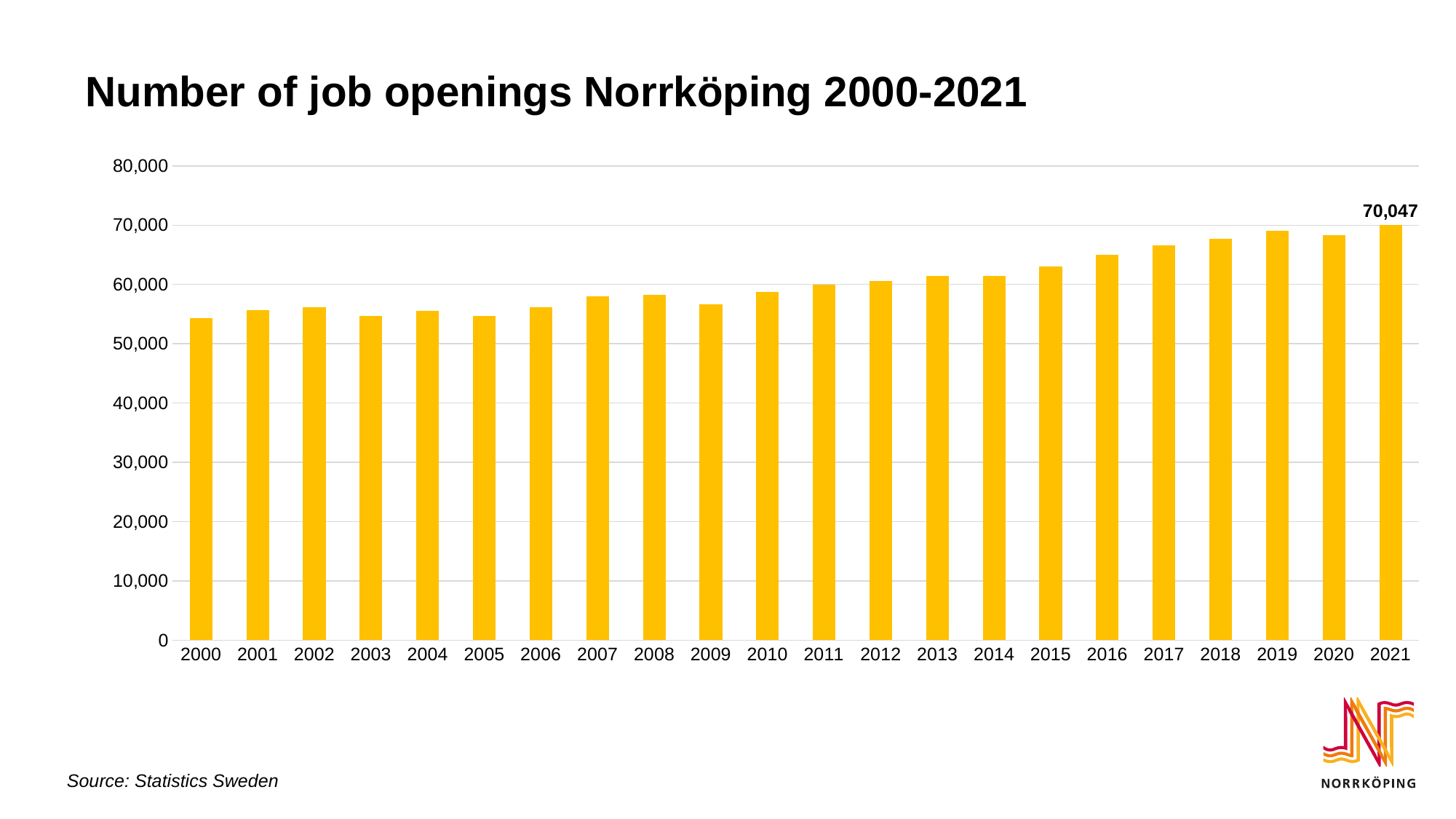
What is the number of job openings in Norrköping in 2021? 70,047 What is the source cited for the chart data? Statistics Sweden Which year has more job openings, 2009 or 2016? 2016 Which year has more job openings, 2000 or 2021? 2021 Is the value for 2010 greater or less than 60,000? less How many years are shown on the x axis? 22 Is the value for 2000 greater or less than 60,000? less Is the value for 2019 greater or less than 60,000? greater What kind of chart is shown on the slide? Bar chart Which year has the highest number of job openings? 2021 Do the number of job openings generally rise or fall from 2000 to 2021? Rise